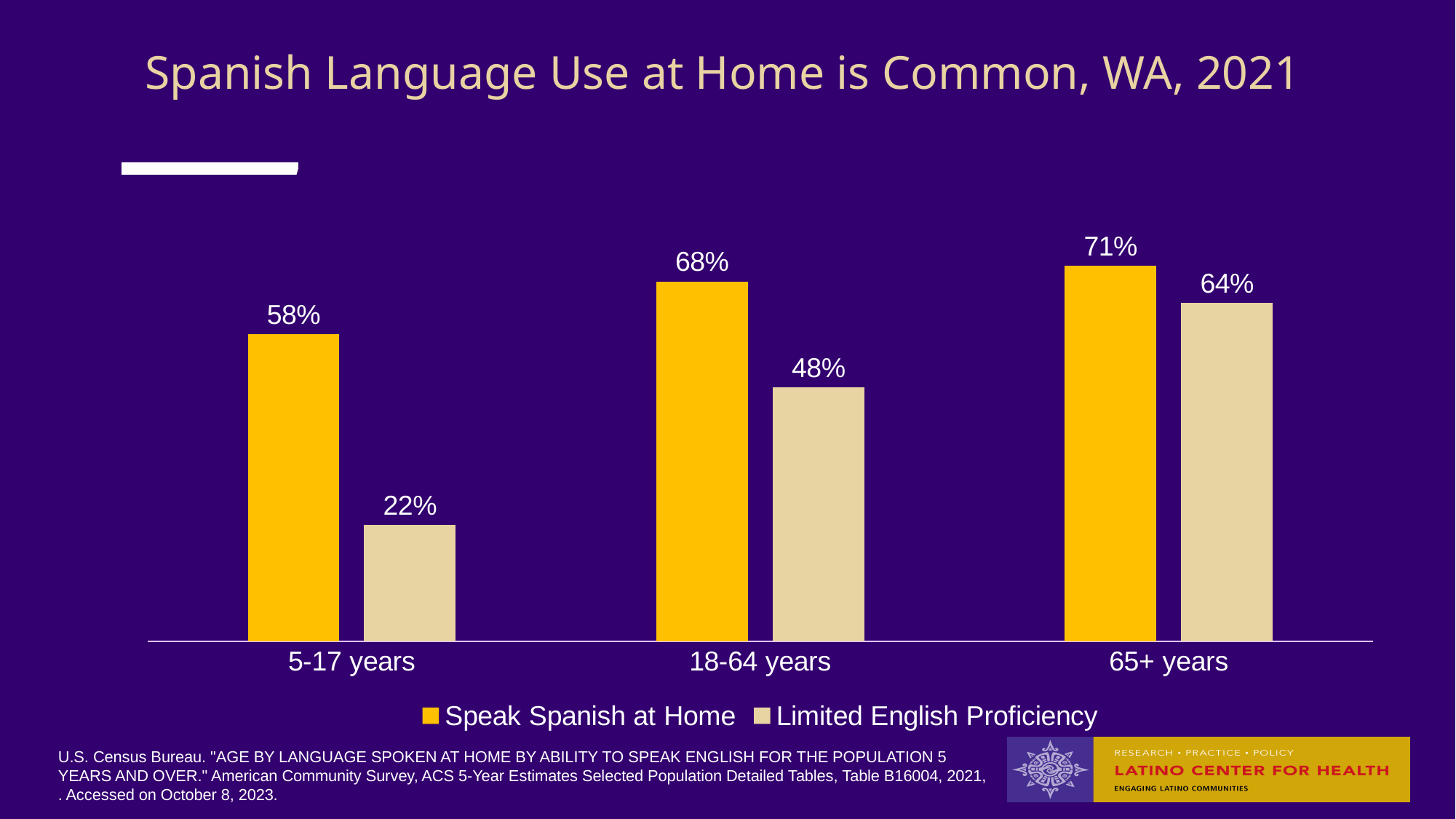
Which age group has the highest value for Speak Spanish at Home? 65+ years Do the Limited English Proficiency values rise or fall from the youngest to the oldest age group? Rise How many series does the legend list? 2 How many age groups are shown on the x axis? 3 What is the difference in Limited English Proficiency between the 65+ years and 18-64 years groups? 16% Which is larger: Speak Spanish at Home for 18-64 years or Limited English Proficiency for 65+ years? Speak Spanish at Home for 18-64 years What kind of chart is shown on the slide? Bar chart What percentage of the 5-17 years group speaks Spanish at home? 58% What is the Limited English Proficiency value for the 18-64 years group? 48% Which age group has the lowest value for Limited English Proficiency? 5-17 years What is the difference between the Speak Spanish at Home and Limited English Proficiency values for the 5-17 years group? 36% What is the Limited English Proficiency value for the 65+ years group? 64%